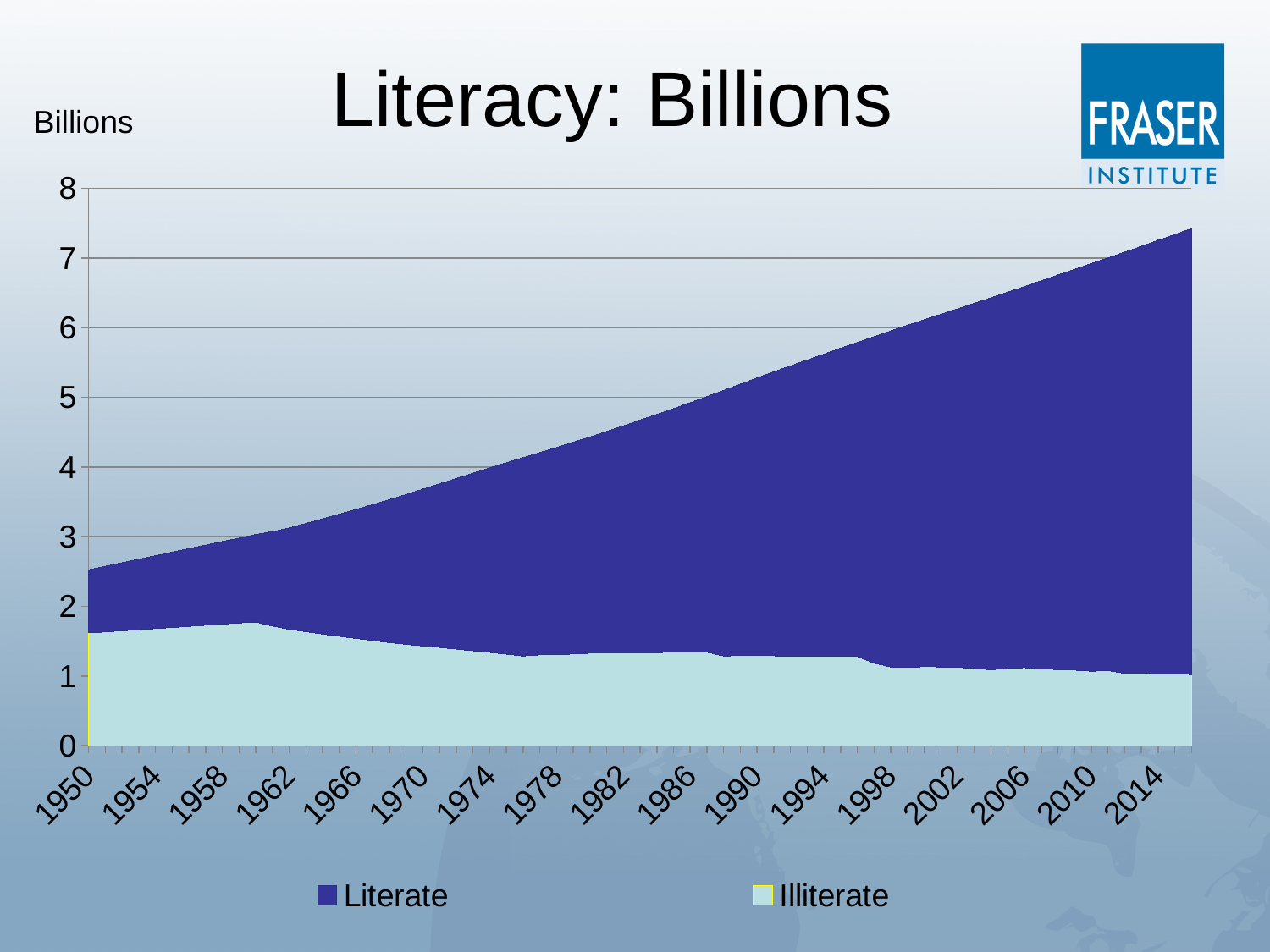
Does the Illiterate series rise or fall overall from 1962 to 2014? Falls What are the two series named in the legend? Literate and Illiterate Is the total value (top of the stacked area) in 2014 greater or less than 7? greater What is the title of the chart? Literacy: Billions Which series is larger in 2014, Literate or Illiterate? Literate Is the total value (top of the stacked area) in 1950 greater or less than 3? less Is the Illiterate value in 2014 greater or less than 1.5? less What kind of chart is shown on the slide? Stacked area chart Does the total population (top of the stacked area) rise or fall from 1950 to 2014? Rises How many series does the legend list? 2 Which series is larger in 1950, Literate or Illiterate? Illiterate